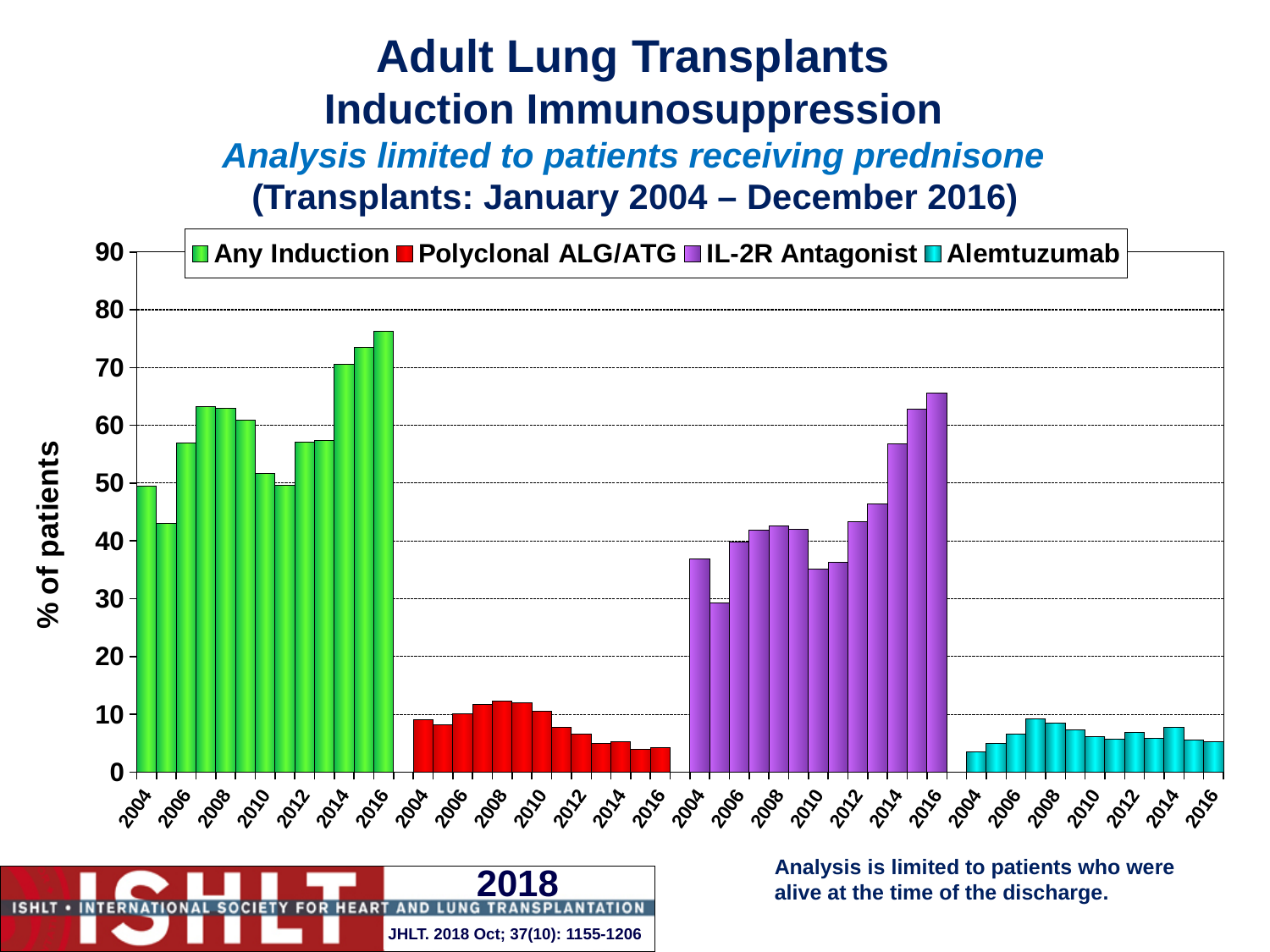
What kind of chart is shown on the slide? Bar chart Do the Polyclonal ALG/ATG values rise or fall from 2008 to 2016? fall In which year is the Any Induction value highest? 2016 Is the Any Induction value for 2016 greater or less than 70? greater How many series does the legend list? 4 Which is larger in 2016: the Any Induction value or the IL-2R Antagonist value? Any Induction Is the Polyclonal ALG/ATG value for 2008 greater or less than 10? greater In which year is the Any Induction value lowest? 2005 What is the label on the y axis? % of patients In which year is the IL-2R Antagonist value lowest? 2005 How many years (bars) are plotted for the Any Induction series? 13